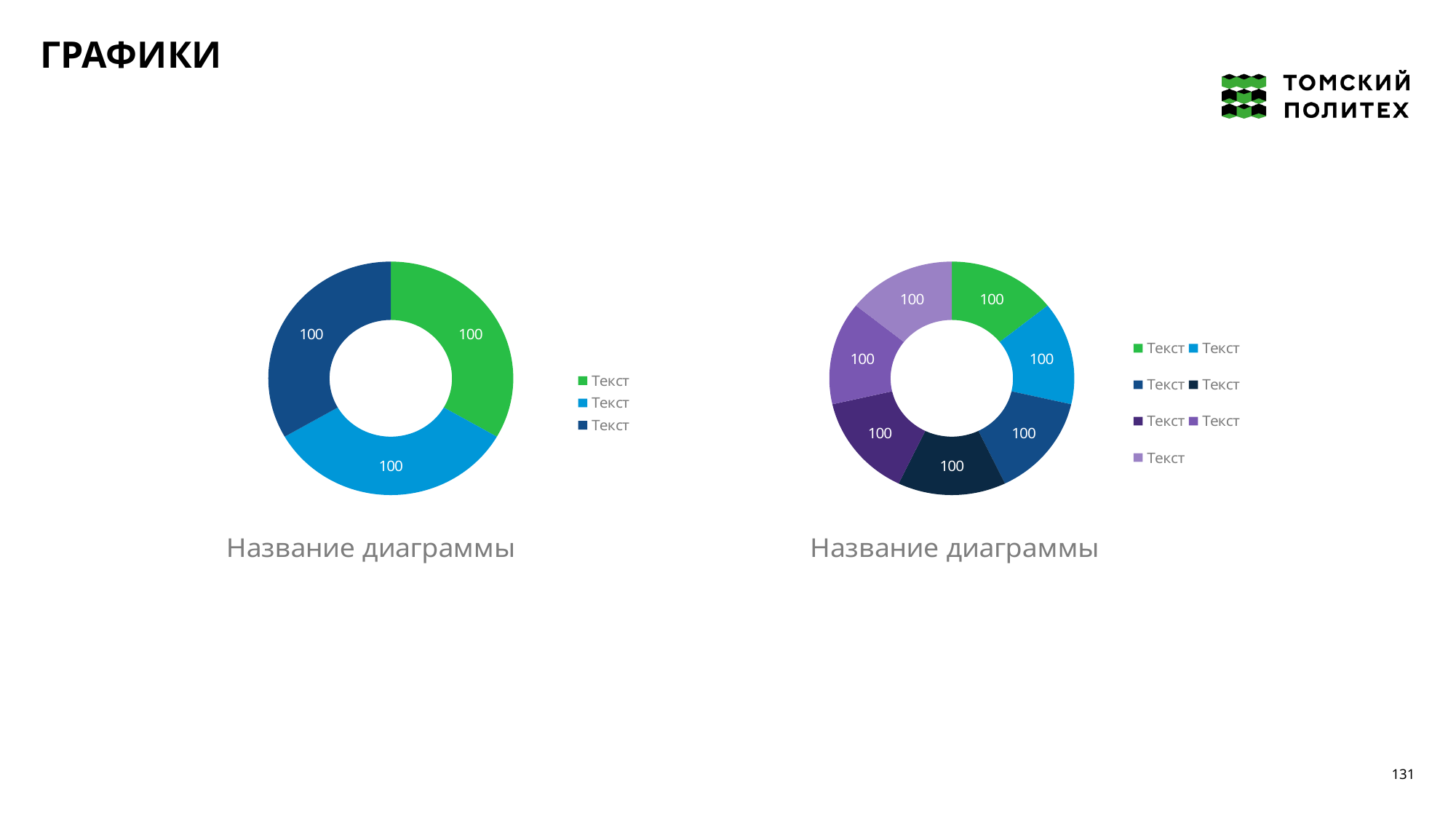
In the chart on the left, what is the total of all the slice values? 300 In the chart on the left, what value is shown on the light blue slice at the bottom? 100 In the chart on the left, what value is shown on the green slice? 100 What kind of chart is the chart on the left side of the slide? Doughnut (pie) chart In the chart on the right, what value is shown on the light purple slice at the top left? 100 In the chart on the left, how many entries does the legend list? 3 In the chart on the left, how many slices does the doughnut have? 3 What kind of chart is the chart on the right side of the slide? Doughnut (pie) chart In the chart on the right, how many entries does the legend list? 7 In the chart on the right, how many slices does the doughnut have? 7 What is the title shown under the chart on the left? Название диаграммы In the chart on the right, what is the total of all the slice values? 700